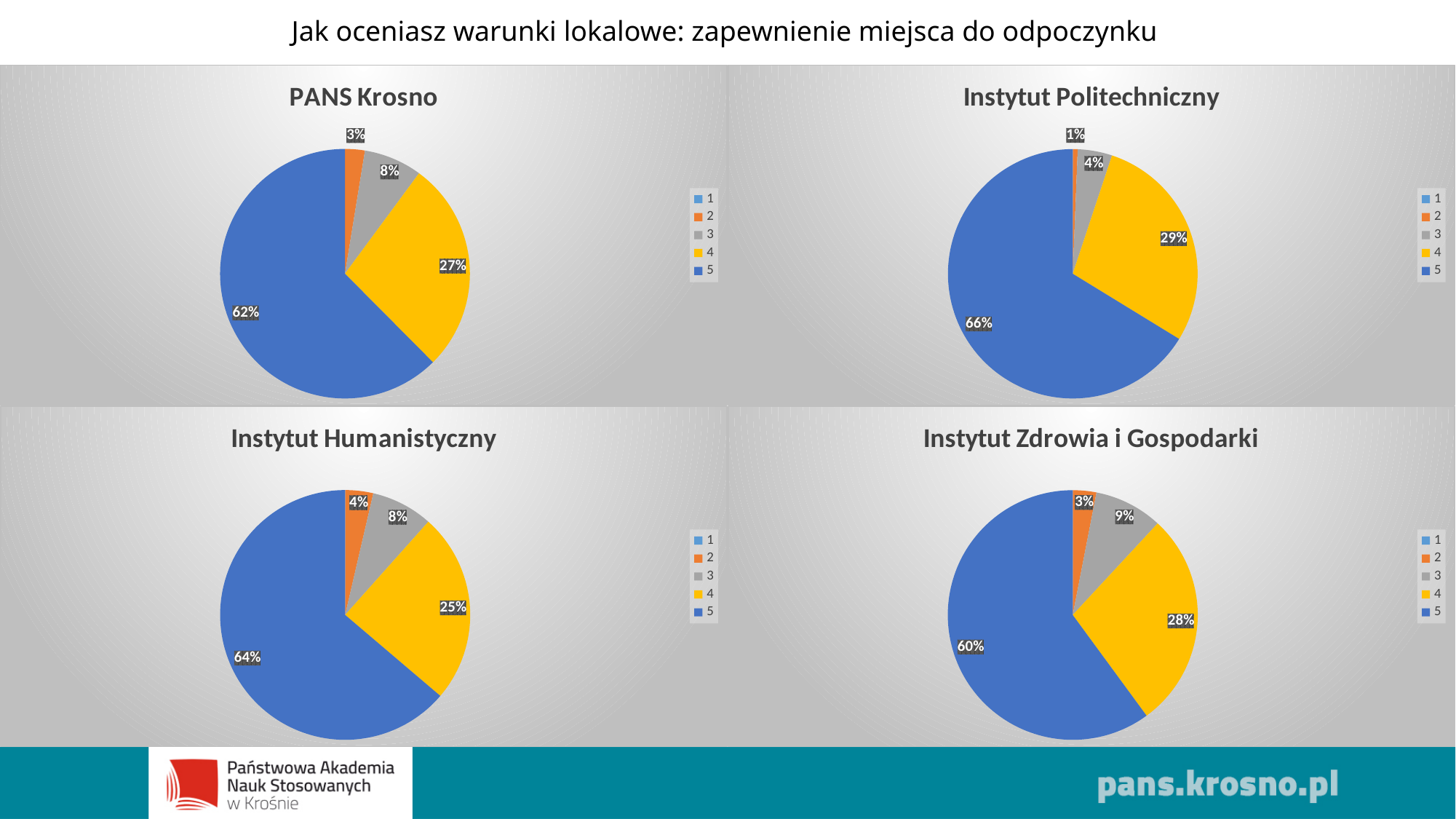
In the Instytut Politechniczny chart, which category has the largest slice? 5 In the Instytut Zdrowia i Gospodarki chart, what percentage is shown for category 3? 9% In the PANS Krosno chart, what is the difference between the percentages for category 5 and category 4? 35% In the Instytut Zdrowia i Gospodarki chart, which labelled category has the smallest slice? 2 How many entries does the legend of the PANS Krosno chart list? 5 What type of chart is used for Instytut Politechniczny? pie chart In the Instytut Humanistyczny chart, which is larger: the slice for category 3 or the slice for category 4? 4 In the Instytut Politechniczny chart, what percentage is shown for category 4? 29% In the Instytut Zdrowia i Gospodarki chart, what colour is the slice for category 4? yellow In the PANS Krosno chart, what percentage is shown for category 5? 62% In the Instytut Humanistyczny chart, what percentage is shown for category 2? 4% How many pie charts are shown on the slide? 4